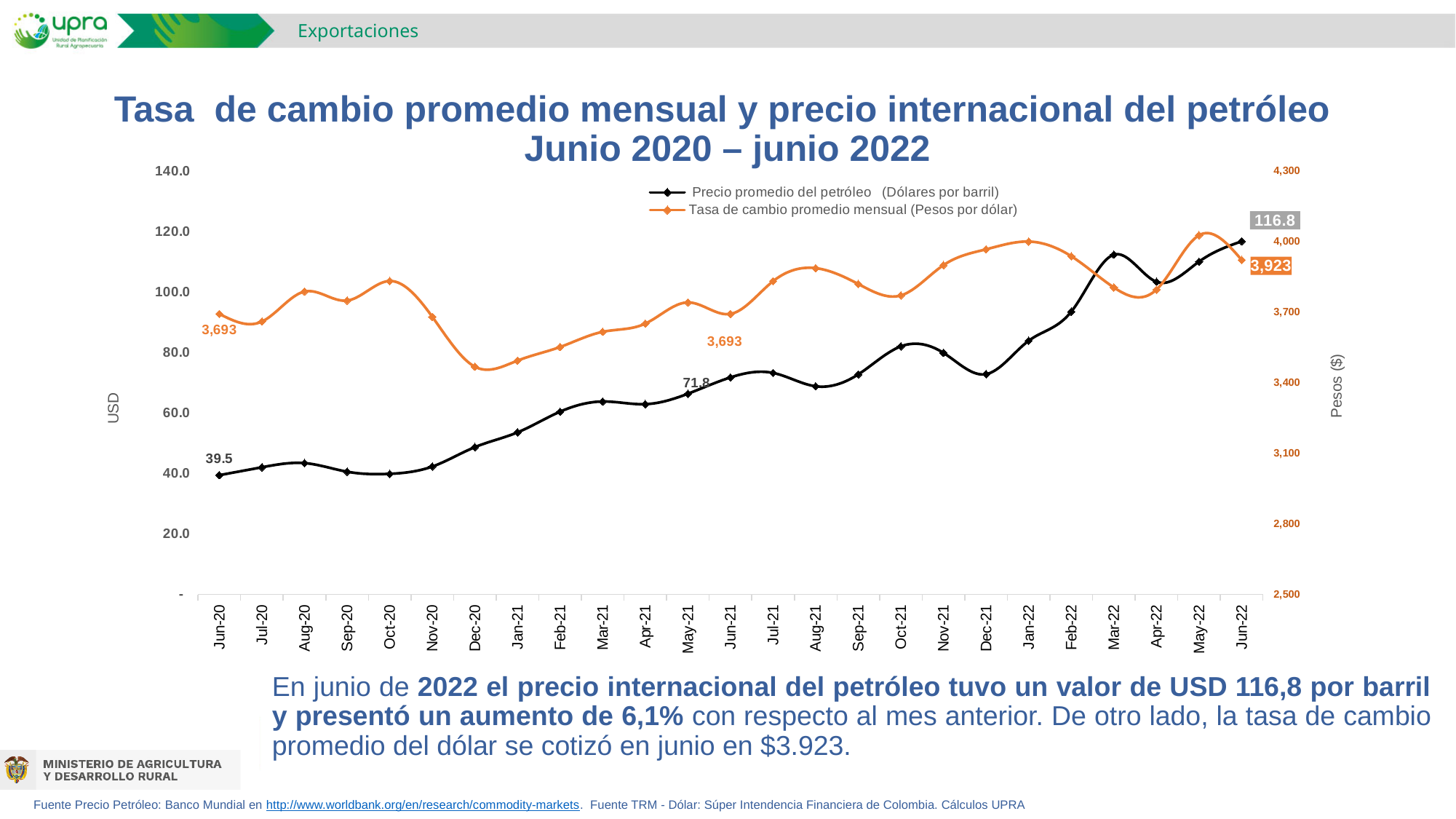
What kind of chart is shown on the slide? Line chart What is the monthly average exchange rate for Jun-20? 3,693 What is the difference between the oil price in Jun-22 and in Jun-20? 77.3 Which is larger, the oil price in Jun-21 or in Jun-22? Jun-22 By how much did the exchange rate in Jun-22 exceed the exchange rate in Jun-20? 230 Is the exchange rate for Jan-22 greater or less than 3,700? greater What is the monthly average exchange rate (Tasa de cambio promedio mensual) for Jun-22? 3,923 How many series does the legend list? 2 What is the average oil price (Precio promedio del petróleo) for Jun-20? 39.5 Which month has the highest average oil price? Jun-22 Is the oil price for Dec-20 greater or less than 60.0? less What is the average oil price for Jun-22? 116.8